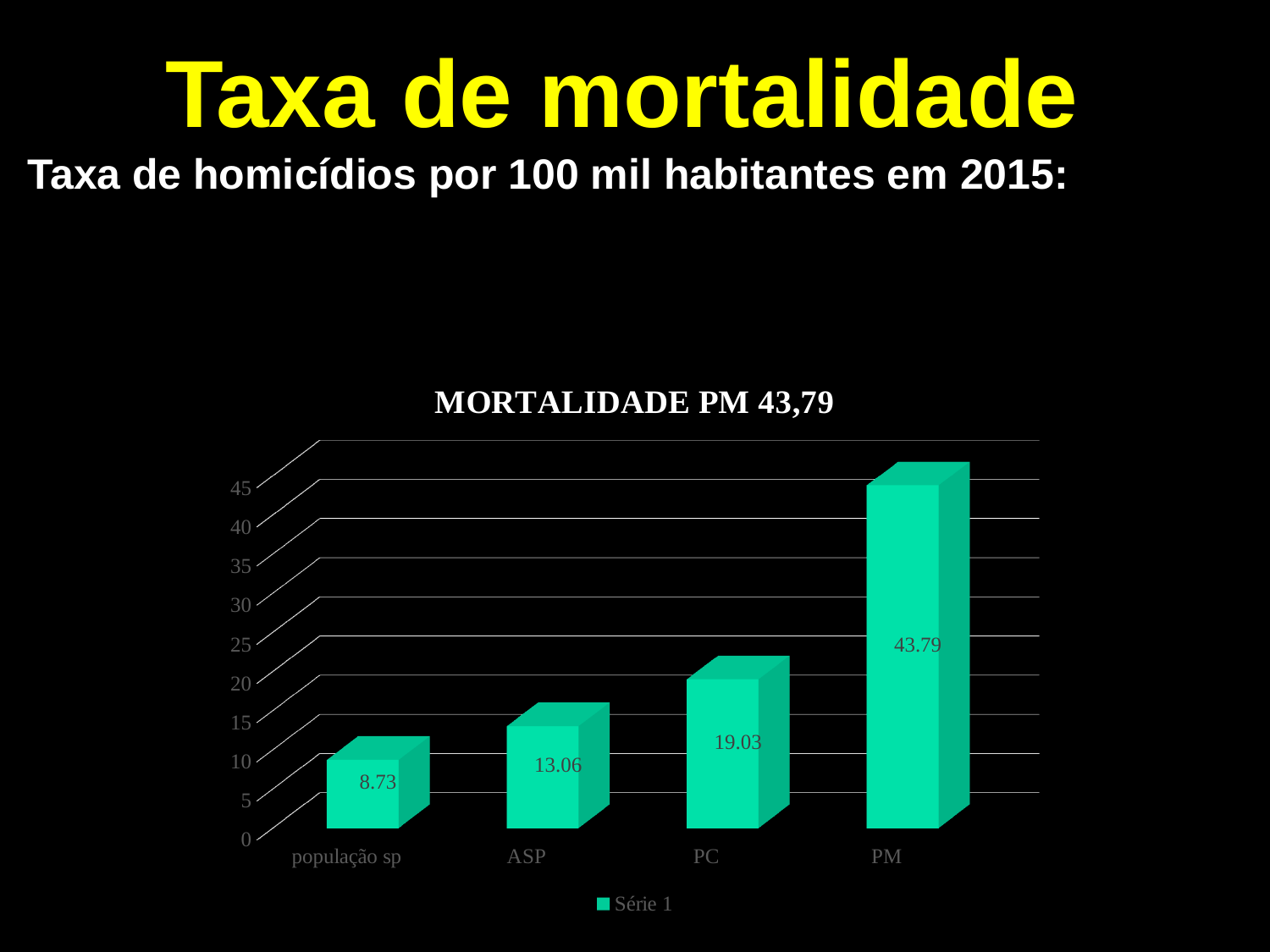
What is the value for PC? 19.03 What is the value for população sp? 8.73 What is the value for PM? 43.79 What is the value for ASP? 13.06 Which category has the lowest value? população sp What kind of chart is shown? bar chart Which category has the highest value? PM What is the difference between the values for PM and PC? 24.76 What is the difference between the values for ASP and população sp? 4.33 What is the title of the chart? MORTALIDADE PM 43,79 Which is larger, the value for PC or the value for ASP? PC How many categories are shown on the x axis? 4